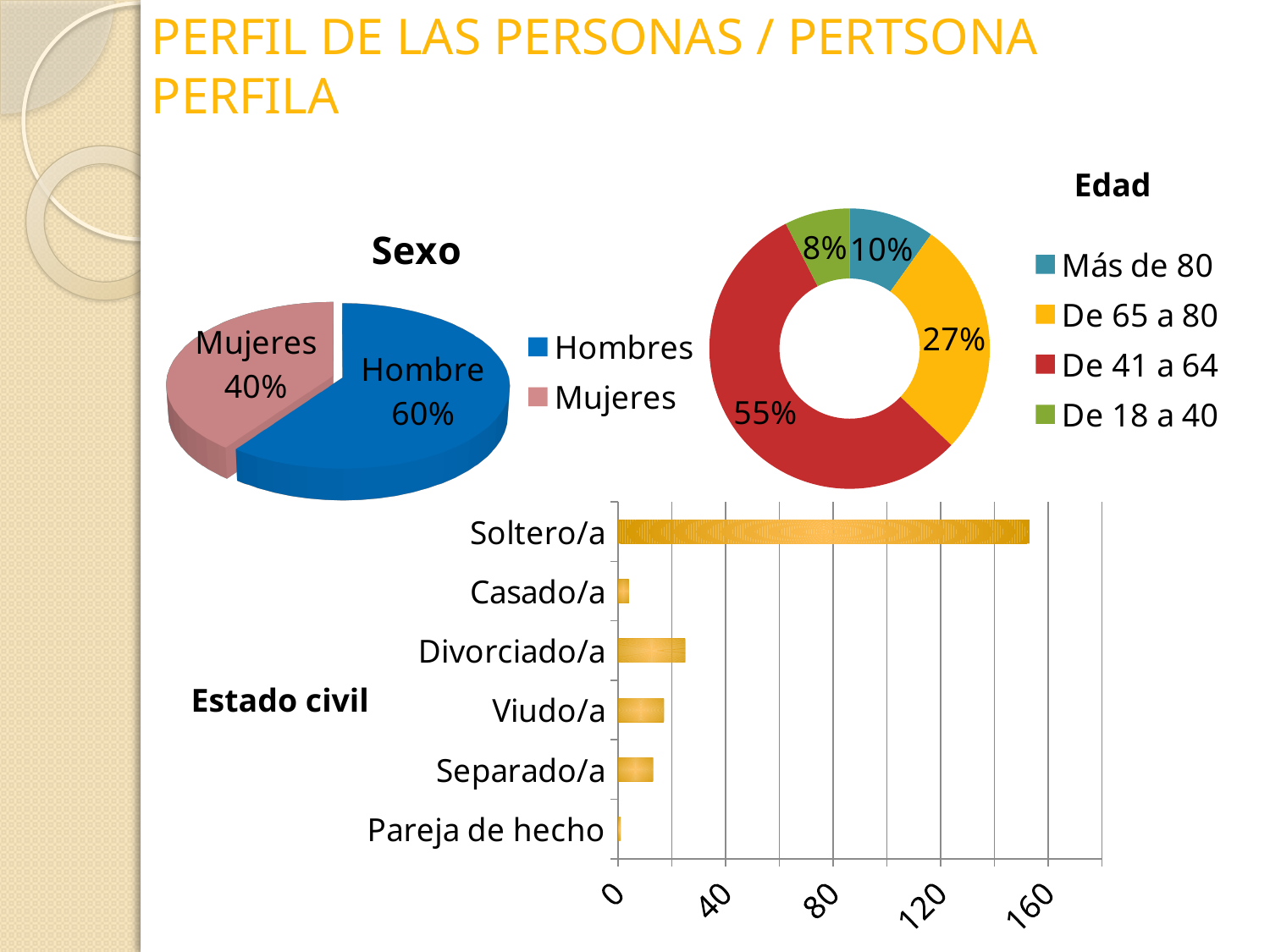
In the Edad chart, which age group has the largest share? De 41 a 64 In the Sexo chart, what is the difference in percentage points between Hombres and Mujeres? 20 percentage points In the Estado civil chart, which is larger, Divorciado/a or Casado/a? Divorciado/a How many categories does the legend of the Edad chart list? 4 In the Sexo chart, what percentage is shown for Hombres? 60% In the Edad chart, what percentage is shown for Más de 80? 10% In the Sexo chart, what percentage is shown for Mujeres? 40% In the Estado civil chart, is the value for Soltero/a greater or less than 120? greater In the Estado civil chart, which category has the highest value? Soltero/a In the Edad chart, which age group has the smallest share? De 18 a 40 How many categories are shown in the Estado civil chart? 6 In the Edad chart, what percentage is shown for De 41 a 64? 55%